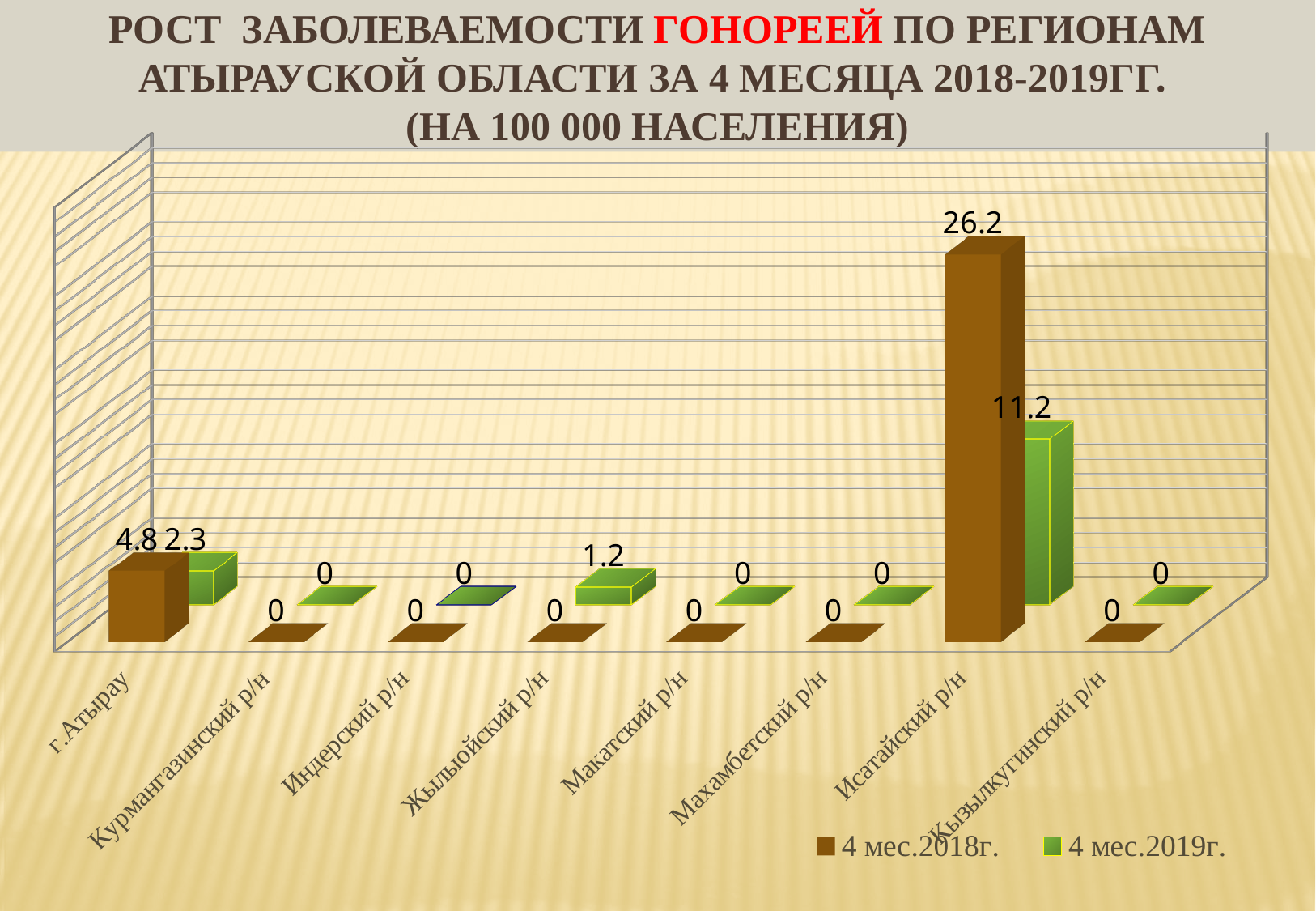
What is the value for Жылыойский р/н in the 4 мес.2019г. series? 1.2 How many regions are shown on the x axis? 8 Which is larger for г.Атырау: the 4 мес.2018г. value or the 4 мес.2019г. value? 4 мес.2018г. Which region has the highest value in the 4 мес.2018г. series? Исатайский р/н What is the difference between the 4 мес.2018г. and 4 мес.2019г. values for г.Атырау? 2.5 What is the value for Исатайский р/н in the 4 мес.2019г. series? 11.2 What is the value for г.Атырау in the 4 мес.2018г. series? 4.8 What is the value for Макатский р/н in the 4 мес.2019г. series? 0 What is the difference between the 4 мес.2018г. and 4 мес.2019г. values for Исатайский р/н? 15 What is the value for Исатайский р/н in the 4 мес.2018г. series? 26.2 What kind of chart is shown on the slide? Bar chart How many series does the legend list? 2